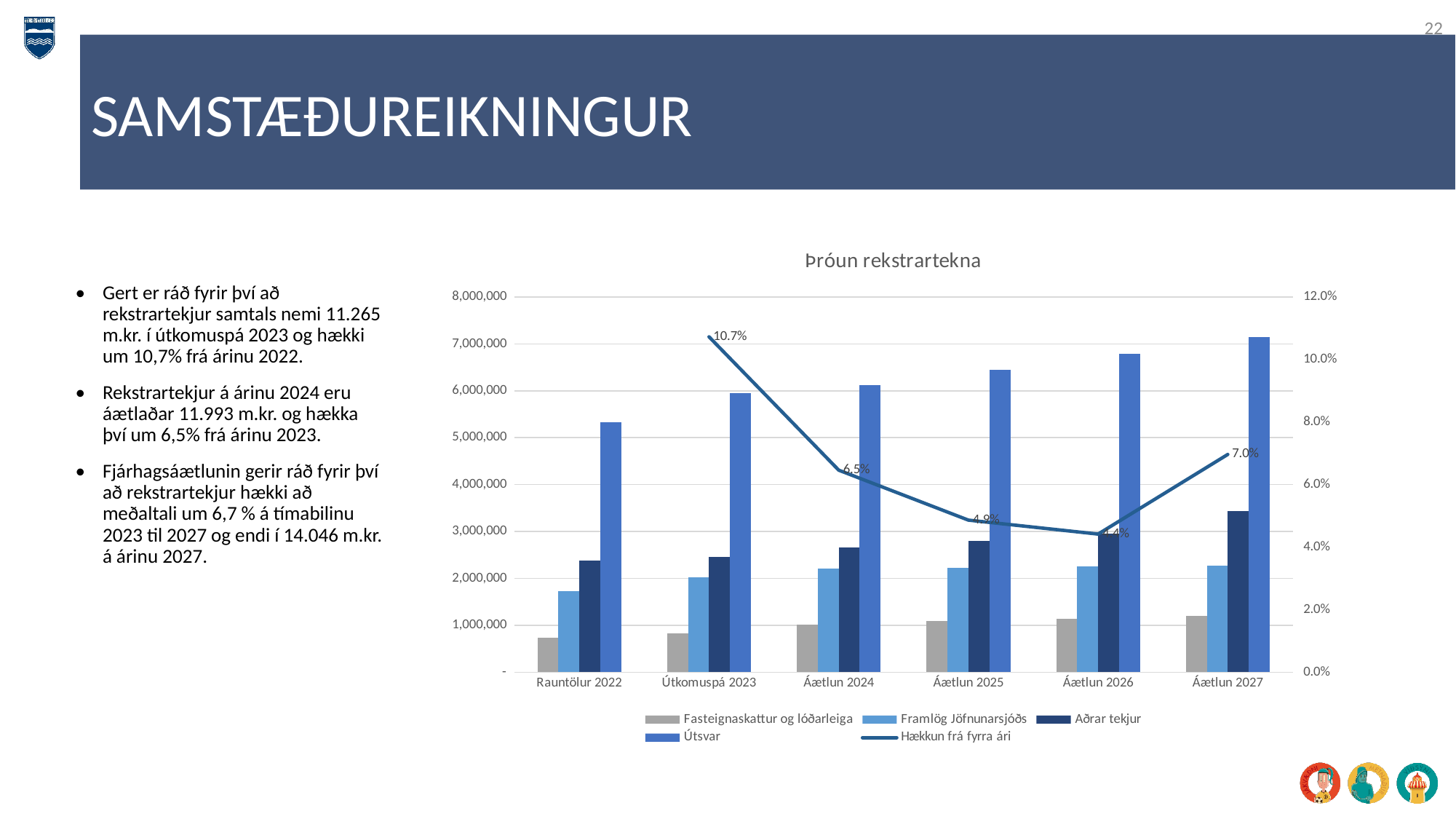
In which category is the Hækkun frá fyrra ári line at its highest? Útkomuspá 2023 How many categories are shown on the x axis of the chart? 6 Is the Útsvar value for Rauntölur 2022 greater or less than 5,000,000? greater What is the value of Hækkun frá fyrra ári for Áætlun 2024? 6.5% Do the Útsvar bars rise or fall from Rauntölur 2022 to Áætlun 2027? rise What is the value of Hækkun frá fyrra ári for Útkomuspá 2023? 10.7% By how many percentage points does Hækkun frá fyrra ári fall from Útkomuspá 2023 to Áætlun 2024? 4.2 percentage points Is the Fasteignaskattur og lóðarleiga value for Rauntölur 2022 greater or less than 1,000,000? less What is the title of the chart? Þróun rekstrartekna What is the value of Hækkun frá fyrra ári for Áætlun 2027? 7.0% What kind of chart is shown on the slide? Bar chart with a line How many series does the chart legend list? 5